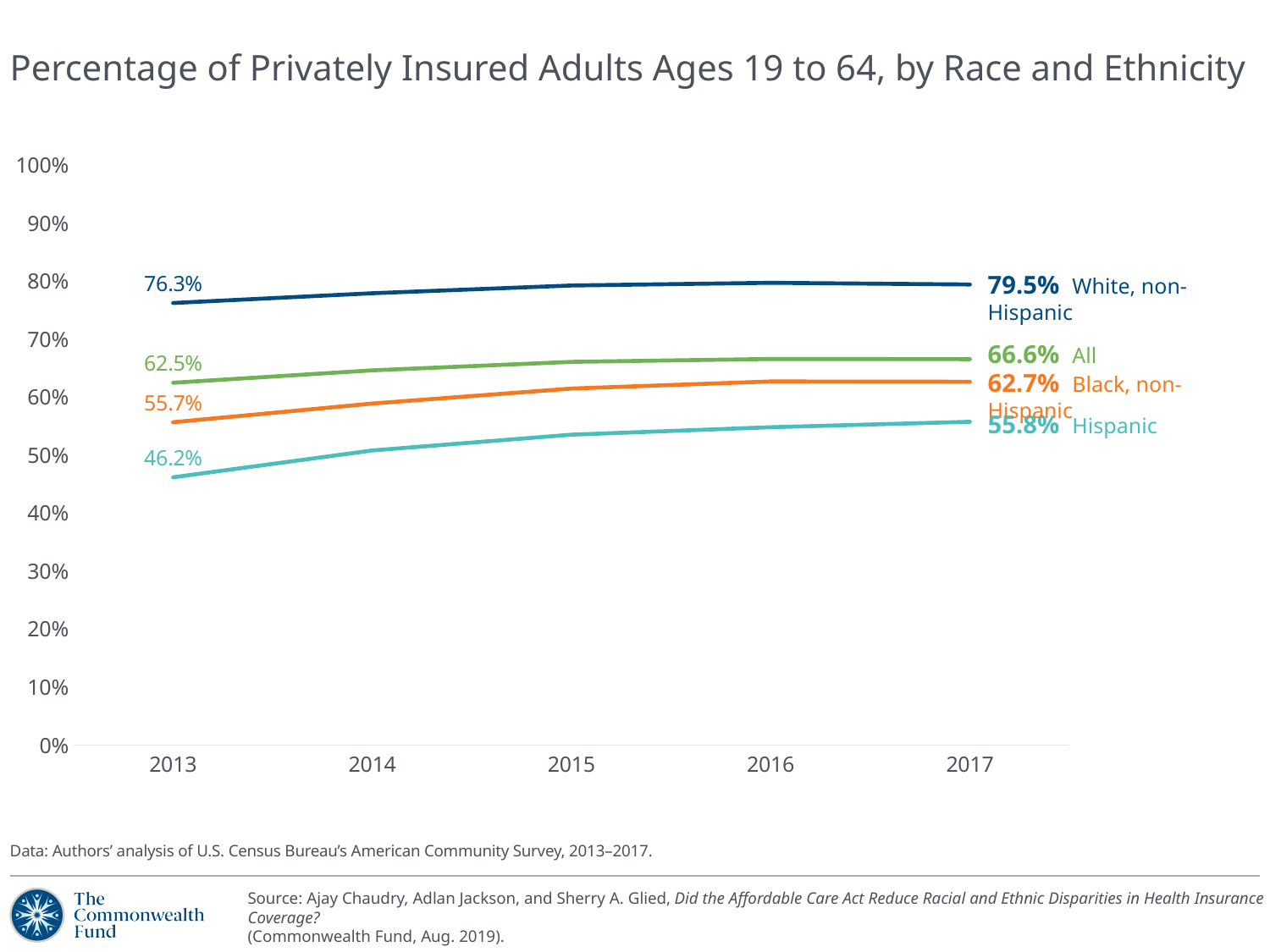
By how many percentage points did the Hispanic rate increase from 2013 to 2017? 9.6 percentage points Which group had the lowest percentage of privately insured adults in 2013? Hispanic What was the value for All adults in 2013? 62.5% How many years are shown on the x axis? 5 Does the Hispanic line rise or fall from 2013 to 2017? Rise What was the percentage of privately insured Black, non-Hispanic adults in 2017? 62.7% What type of chart is shown on the slide? Line chart What is the difference between the White, non-Hispanic and Black, non-Hispanic rates in 2017? 16.8 percentage points How many groups (lines) are plotted on the chart? 4 What was the percentage of privately insured White, non-Hispanic adults in 2013? 76.3% Which group had the highest percentage of privately insured adults in 2017? White, non-Hispanic What was the percentage of privately insured Hispanic adults in 2017? 55.8%